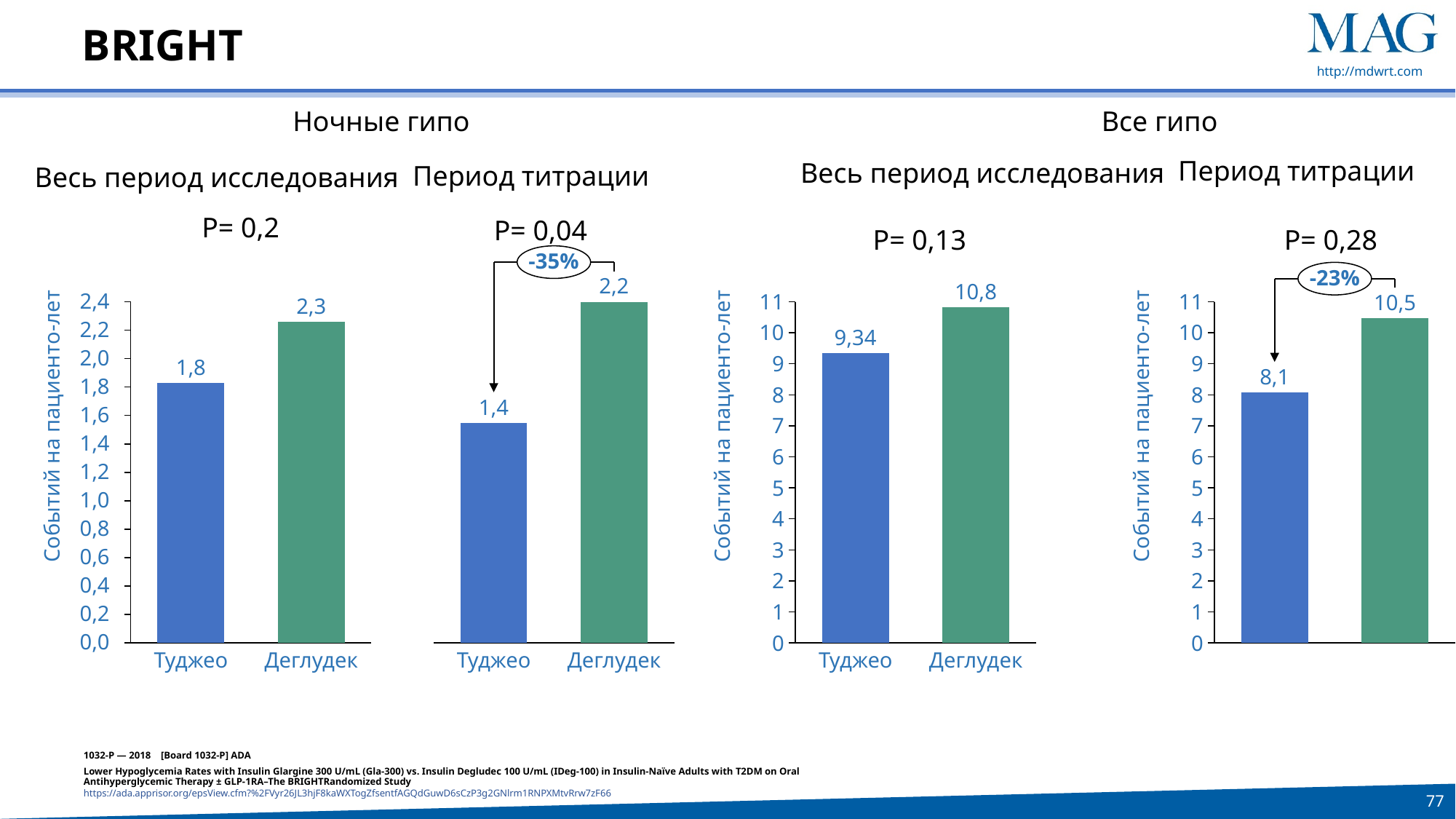
In the leftmost chart (Ночные гипо, Весь период исследования), what is the value for Туджео? 1,8 What type of chart is used for the Ночные гипо, Период титрации data? bar chart In the second chart from the left (Ночные гипо, Период титрации), what is the difference between the Деглудек and Туджео values? 0,8 In the leftmost chart (Ночные гипо, Весь период исследования), what is the value for Деглудек? 2,3 In the leftmost chart (Ночные гипо, Весь период исследования), is the value for Туджео greater or less than 2,0? less In the second chart from the left (Ночные гипо, Период титрации), what is the value for Туджео? 1,4 In the third chart from the left (Все гипо, Весь период исследования), which category has the higher value? Деглудек In the rightmost chart (Все гипо, Период титрации), what is the value of the blue bar? 8,1 In the rightmost chart (Все гипо, Период титрации), what is the value of the green bar? 10,5 In the third chart from the left (Все гипо, Весь период исследования), what is the value for Туджео? 9,34 In the rightmost chart (Все гипо, Период титрации), what is the difference between the green bar and the blue bar? 2,4 How many bars are plotted in the leftmost chart (Ночные гипо, Весь период исследования)? 2